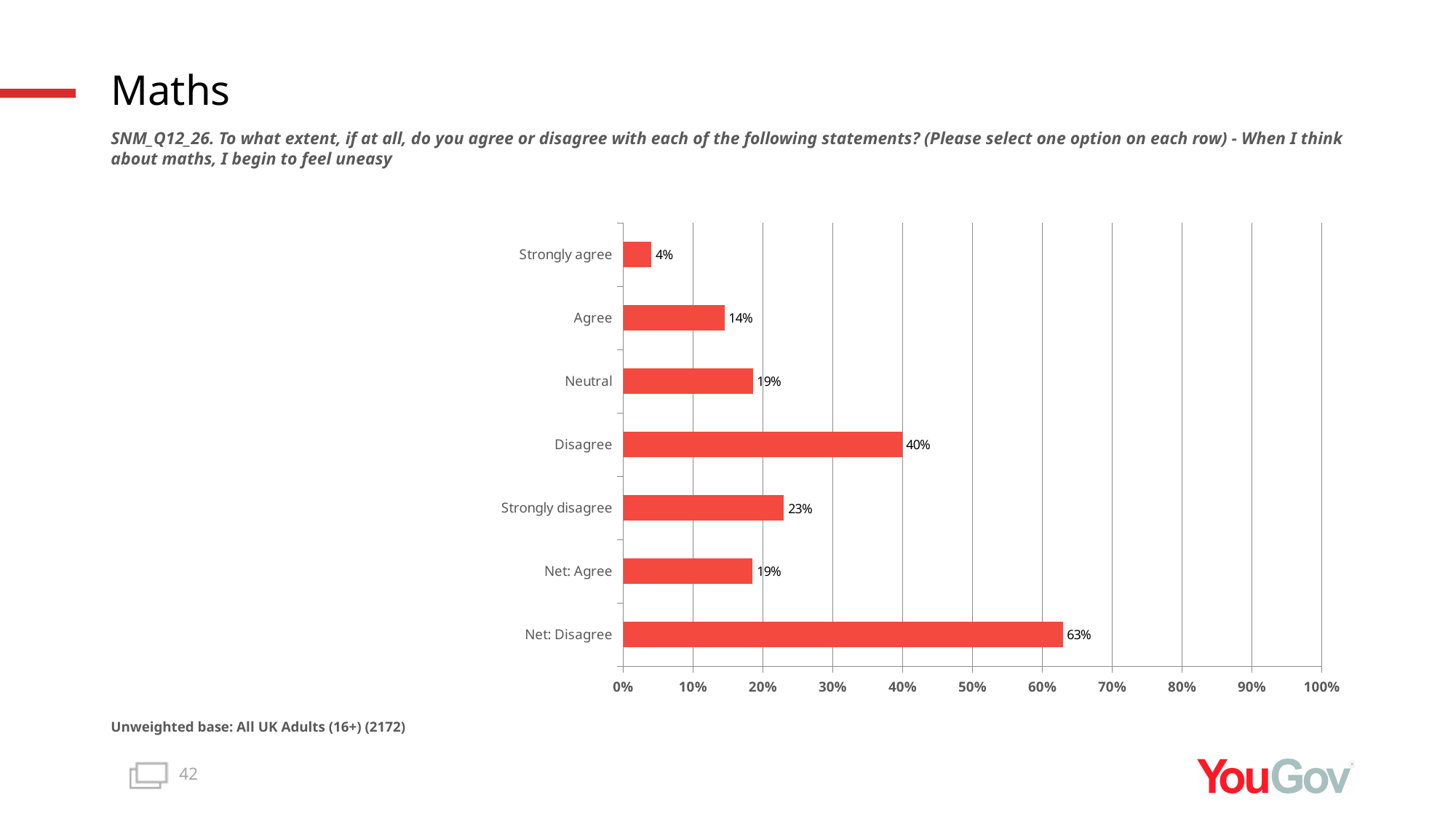
What is the unweighted base stated on the slide? All UK Adults (16+) (2172) How many categories are shown on the chart? 7 Which category has the lowest value? Strongly agree What is the difference between Disagree and Agree? 26% What is the value for Strongly agree? 4% Which category has the highest value? Net: Disagree What is the value for Net: Disagree? 63% What kind of chart is shown on the slide? Bar chart Which is larger, Strongly disagree or Neutral? Strongly disagree What is the value for Strongly disagree? 23% What is the difference between Net: Disagree and Net: Agree? 44% What is the value for Disagree? 40%